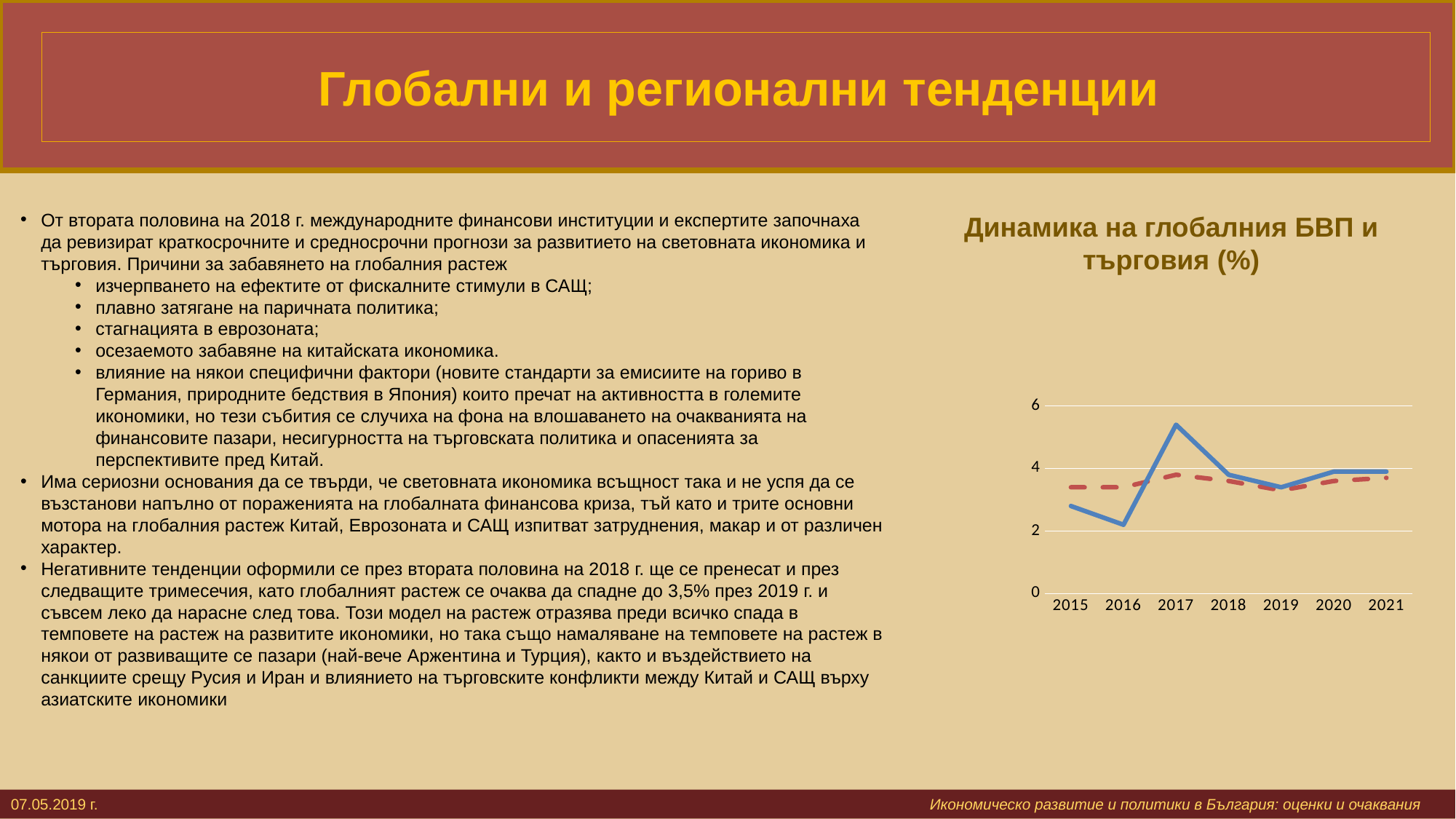
In which year does the solid blue line reach its highest value? 2017 Is the value of the solid blue line in 2015 greater or less than 4? less Does the solid blue line rise or fall from 2016 to 2017? rise Is the value of the solid blue line in 2017 greater or less than 4? greater Is the value of the red dashed line in 2017 greater or less than 4? less How many years are shown on the x axis of the chart? 7 In which year does the solid blue line reach its lowest value? 2016 In 2016, which line has the higher value, the solid blue line or the red dashed line? the red dashed line What is the title of the chart on the slide? Динамика на глобалния БВП и търговия (%) How many lines are plotted on the chart? 2 In 2017, which line has the higher value, the solid blue line or the red dashed line? the solid blue line What kind of chart is shown on the slide? line chart